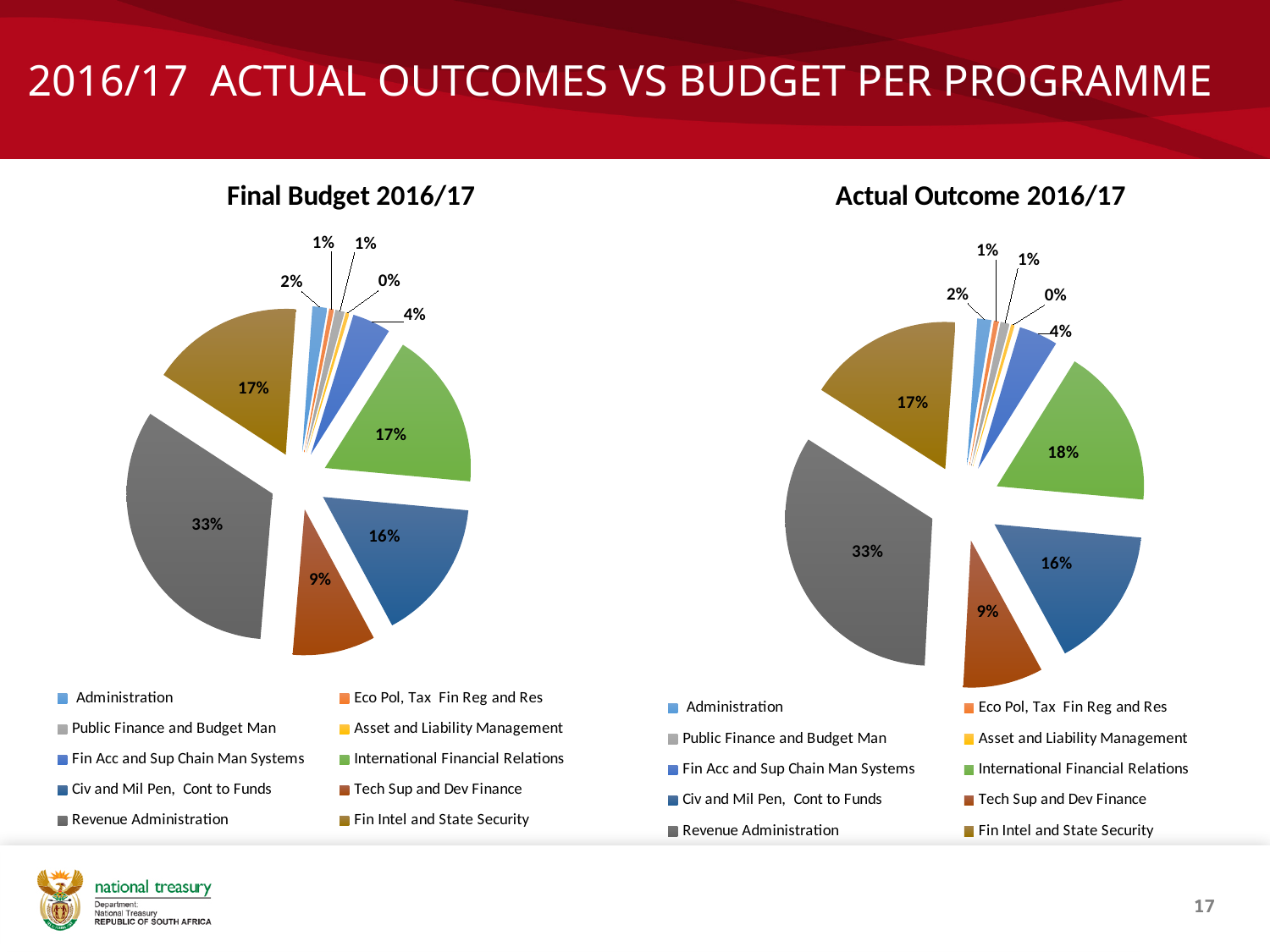
In the Actual Outcome 2016/17 pie chart, what share does Civ and Mil Pen, Cont to Funds have? 16% How many entries does the legend of the Final Budget 2016/17 chart list? 10 What type of chart is the Actual Outcome 2016/17 chart? Pie chart In the Final Budget 2016/17 pie chart, what is the difference between the shares of Revenue Administration and Civ and Mil Pen, Cont to Funds? 17% What is the title of the pie chart on the left of the slide? Final Budget 2016/17 In the Final Budget 2016/17 pie chart, which programme has the largest share? Revenue Administration In the Actual Outcome 2016/17 pie chart, what share does Fin Acc and Sup Chain Man Systems have? 4% In the Actual Outcome 2016/17 pie chart, what share does International Financial Relations have? 18% In the Actual Outcome 2016/17 pie chart, which is larger: International Financial Relations or Fin Intel and State Security? International Financial Relations In the Final Budget 2016/17 pie chart, what share does Revenue Administration have? 33% In the Final Budget 2016/17 pie chart, what share does Tech Sup and Dev Finance have? 9% In the Actual Outcome 2016/17 pie chart, which programme has the smallest share? Asset and Liability Management